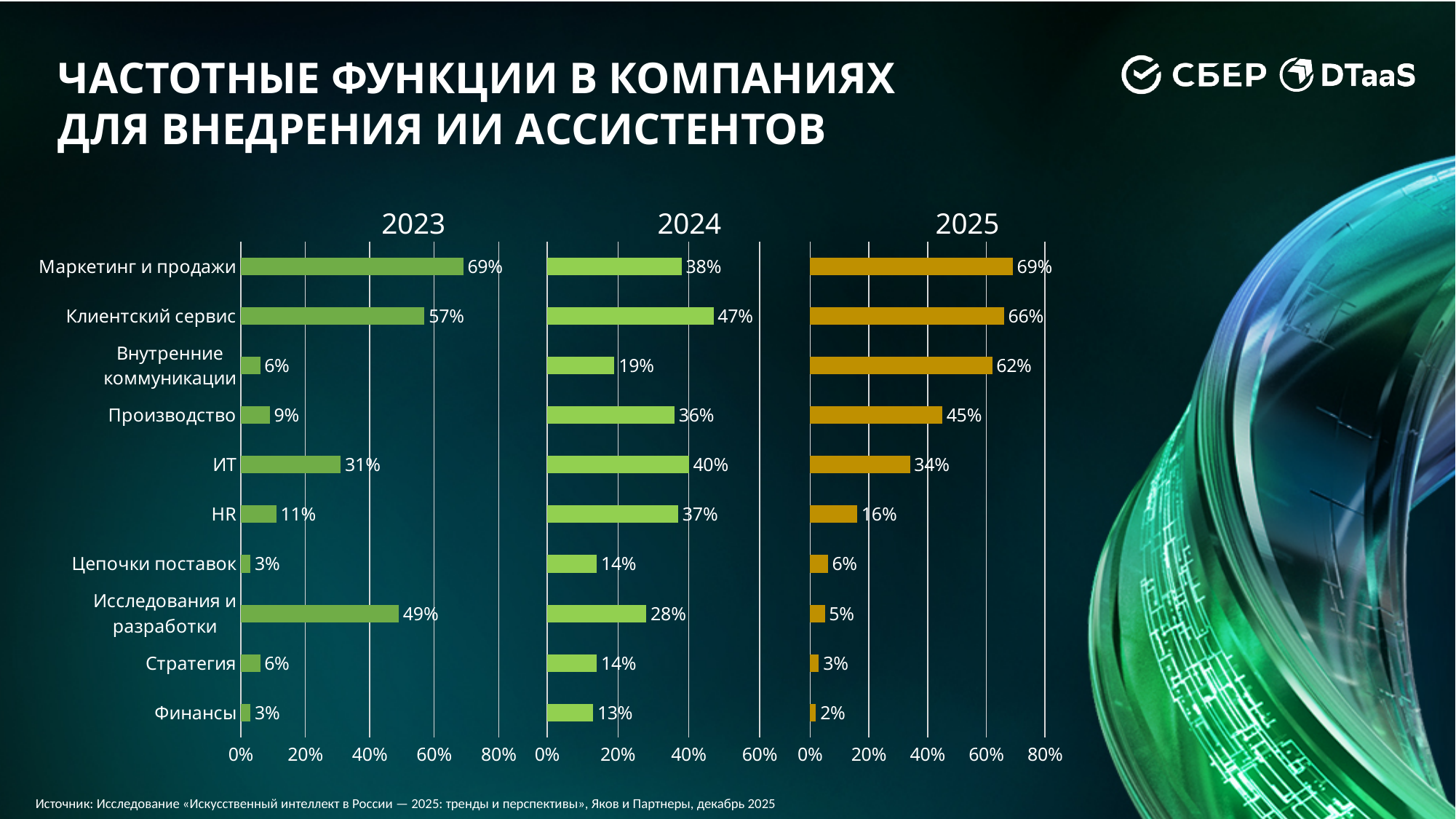
How many charts are shown on the slide? 3 In the 2023 chart, what is the value for Маркетинг и продажи? 69% In the 2025 chart, which is larger: the value for ИТ or the value for Производство? Производство In the 2024 chart, is the value for ИТ greater or less than 20%? greater In the 2025 chart, which category has the lowest value? Финансы In the 2025 chart, what is the value for Внутренние коммуникации? 62% In the 2024 chart, what is the value for Клиентский сервис? 47% What kind of chart is used for the 2025 data? Bar chart How many categories are shown in the 2023 chart? 10 What is the value for Исследования и разработки in the 2025 chart? 5% In the 2023 chart, what is the difference between Маркетинг и продажи and Клиентский сервис? 12% In the 2024 chart, which category has the highest value? Клиентский сервис